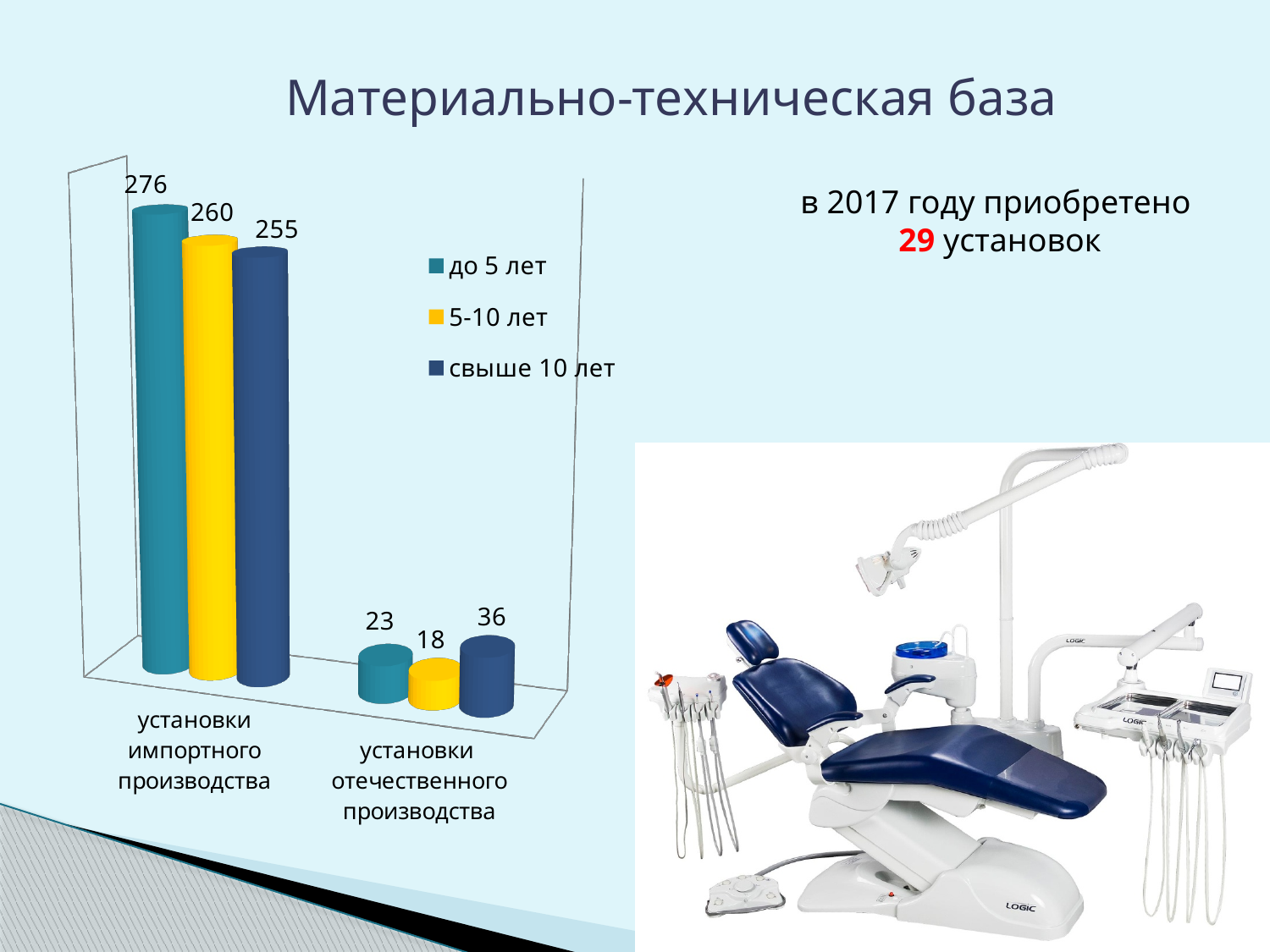
What is the value for 'свыше 10 лет' in the 'установки импортного производства' category? 255 Which series has the lowest value in the 'установки импортного производства' category? свыше 10 лет What is the value for 'до 5 лет' in the 'установки импортного производства' category? 276 What is the value for 'свыше 10 лет' in the 'установки отечественного производства' category? 36 What kind of chart is shown on the slide? bar chart What is the value for '5-10 лет' in the 'установки отечественного производства' category? 18 What is the difference between the 'до 5 лет' and '5-10 лет' values for 'установки импортного производства'? 16 Which is larger: the 'до 5 лет' value for 'установки отечественного производства' or the '5-10 лет' value for the same category? до 5 лет How many categories are shown on the x axis of the chart? 2 Which colour represents the '5-10 лет' series in the chart? yellow How many series does the chart legend list? 3 Which series has the highest value in the 'установки отечественного производства' category? свыше 10 лет